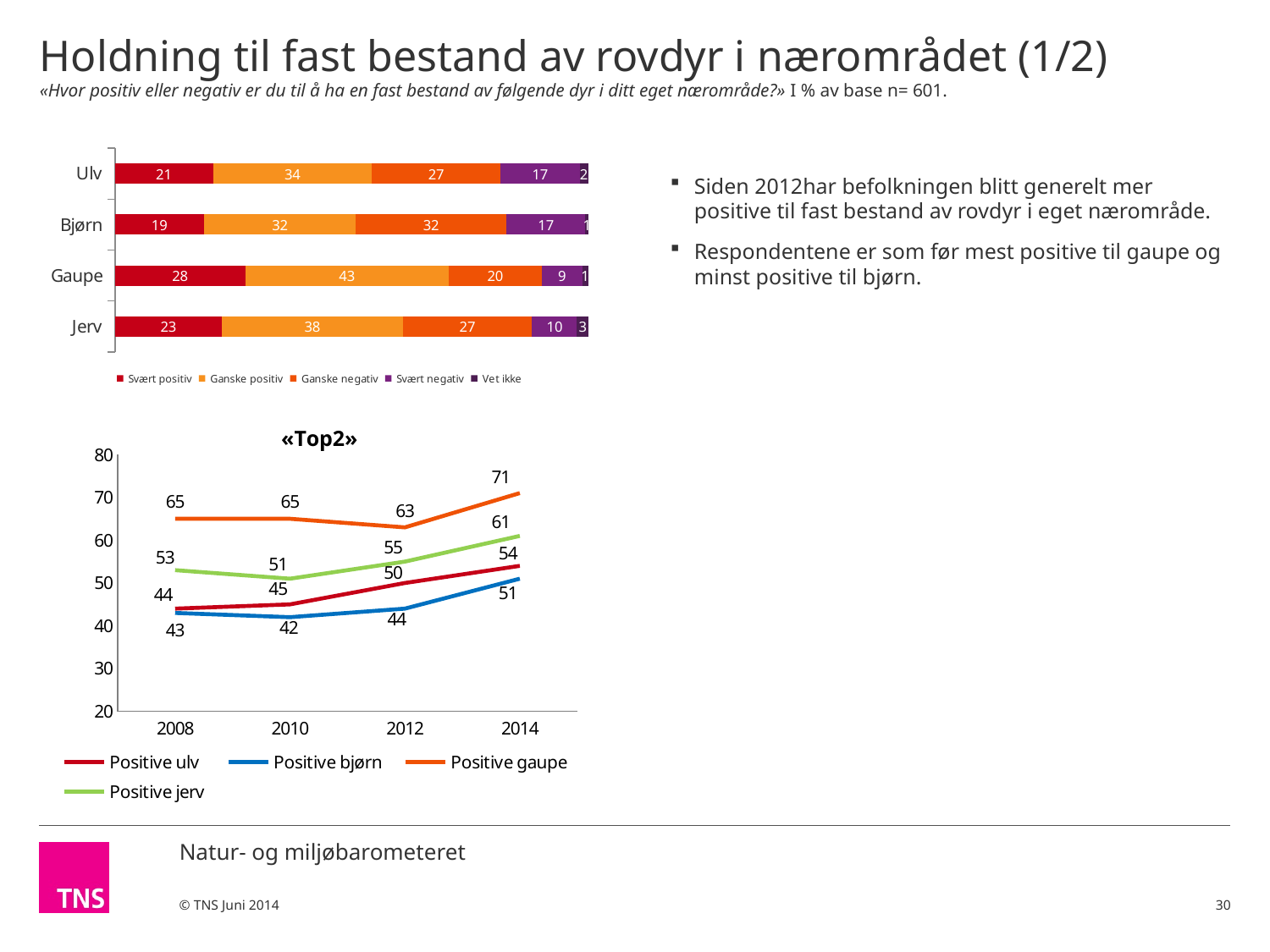
In the stacked bar chart at the top of the slide, which animal has the lowest "Svært negativ" value? Gaupe What kind of chart is the «Top2» chart? Line chart In the «Top2» chart, what is the value for Positive gaupe in 2014? 71 In the stacked bar chart at the top of the slide, which animal has the highest "Ganske positiv" value? Gaupe In the stacked bar chart at the top of the slide, what is the value of "Ganske negativ" for Bjørn? 32 In the «Top2» chart, how many years are shown on the x axis? 4 In the stacked bar chart at the top of the slide, how many series does the legend list? 5 In the stacked bar chart at the top of the slide, what is the value of "Svært positiv" for Gaupe? 28 In the «Top2» chart, is the value for Positive ulv in 2014 larger than the value for Positive bjørn in 2014? Yes In the stacked bar chart at the top of the slide, what is the difference between the "Svært positiv" values for Gaupe and Bjørn? 9 In the «Top2» chart, which series has the highest value in 2012? Positive gaupe In the «Top2» chart, what is the value for Positive bjørn in 2010? 42